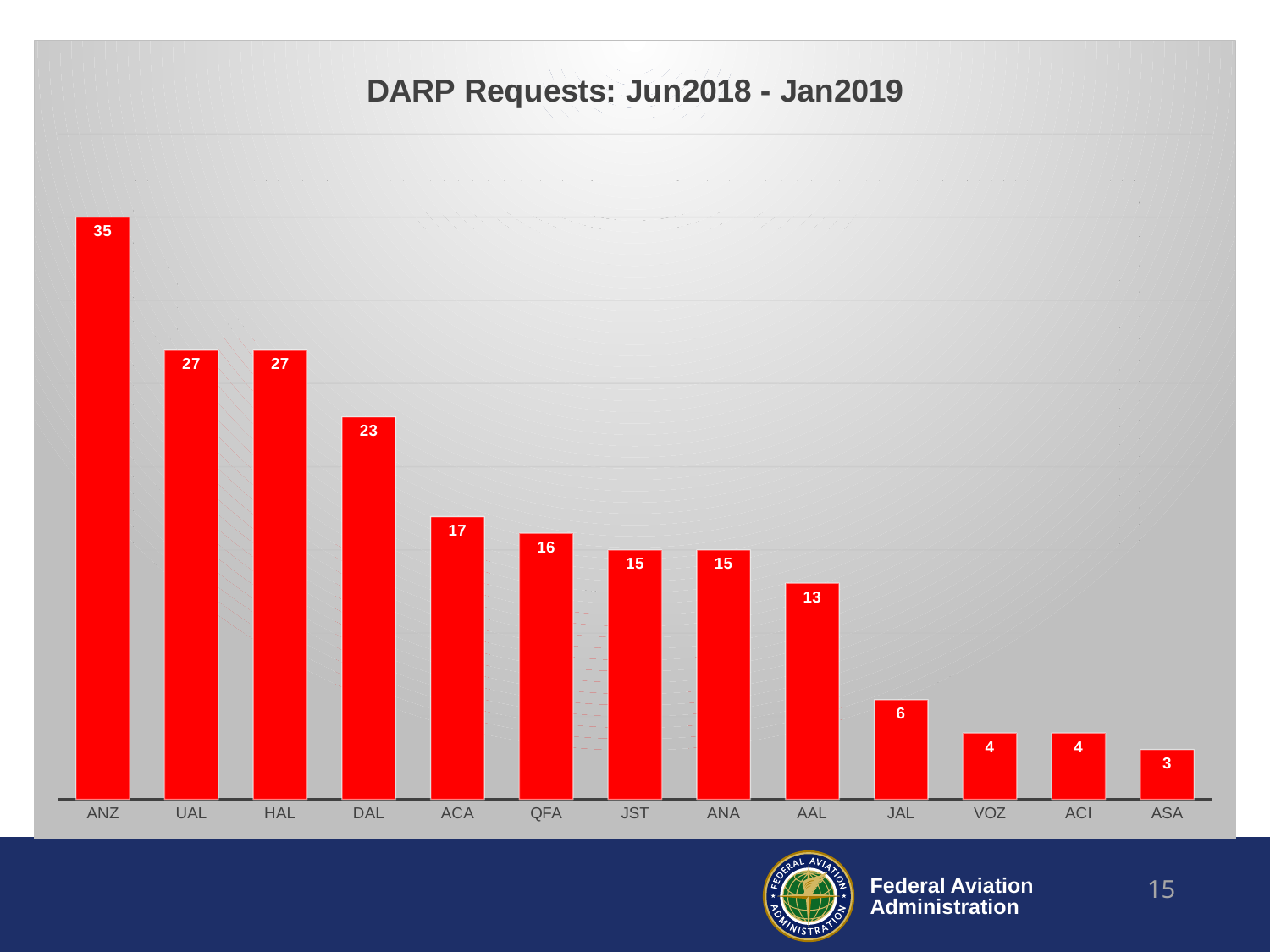
What is the value for ANZ? 35 What kind of chart is this? Bar chart What is the title of the chart? DARP Requests: Jun2018 - Jan2019 What is the value for JAL? 6 Which is larger, the value for QFA or the value for JST? QFA What is the difference between the values for ACA and AAL? 4 What is the value for DAL? 23 Which category has the highest value? ANZ How many categories are shown on the x axis? 13 Do the values rise or fall from left to right along the x axis? Fall What is the difference between the values for ANZ and UAL? 8 Which category has the lowest value? ASA